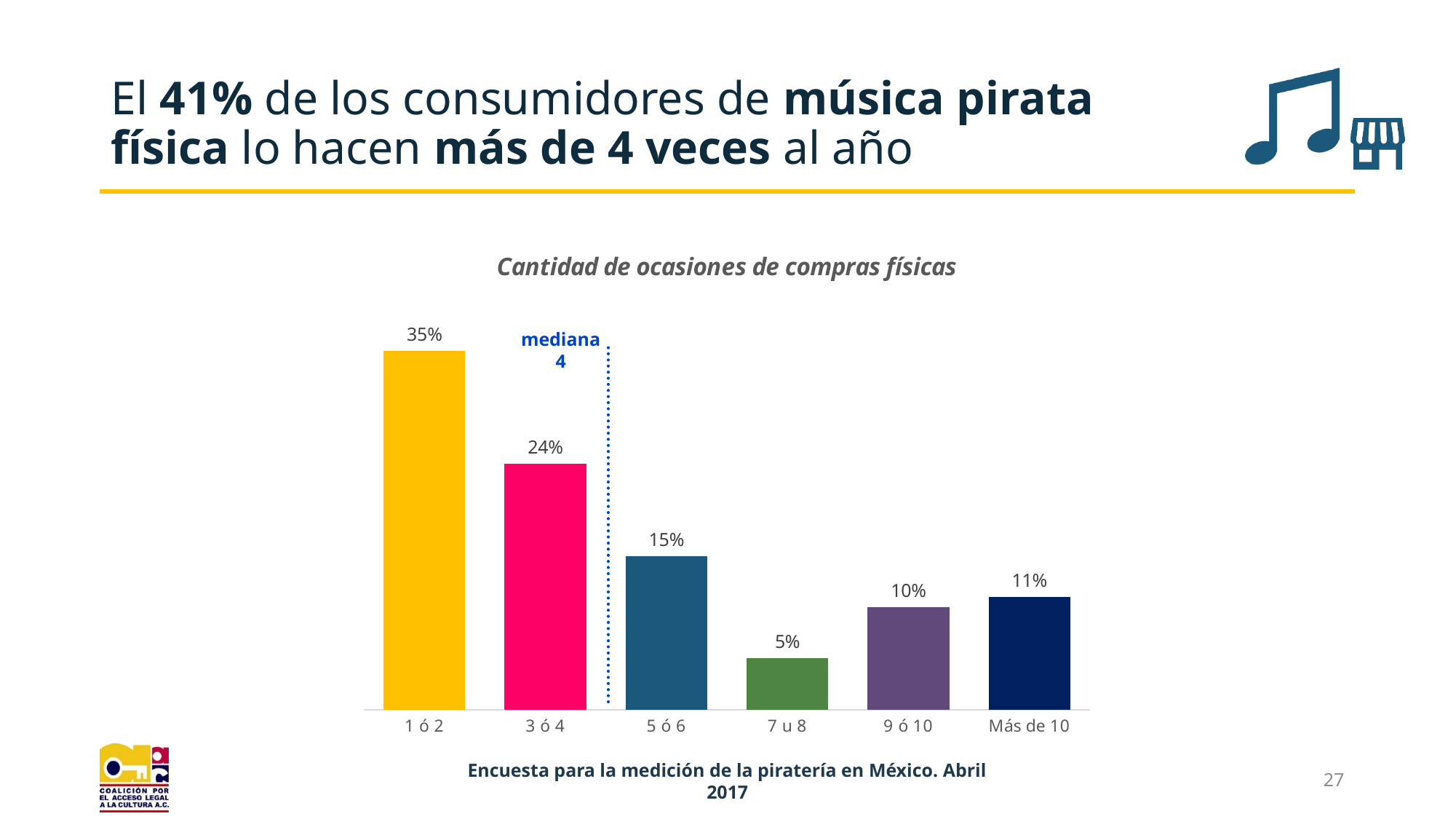
What is the difference between the values for '1 ó 2' and '3 ó 4'? 11% What is the total of the values for '5 ó 6', '7 u 8', '9 ó 10' and 'Más de 10'? 41% What is the value for the '1 ó 2' category? 35% Which is larger, the value for '9 ó 10' or the value for 'Más de 10'? Más de 10 Which category has the highest value? 1 ó 2 What is the title of the chart? Cantidad de ocasiones de compras físicas What is the value for the 'Más de 10' category? 11% What median value is indicated by the dotted line on the chart? 4 What is the value for the '7 u 8' category? 5% What kind of chart is shown on the slide? Bar chart How many categories are shown on the x axis? 6 Which category has the lowest value? 7 u 8